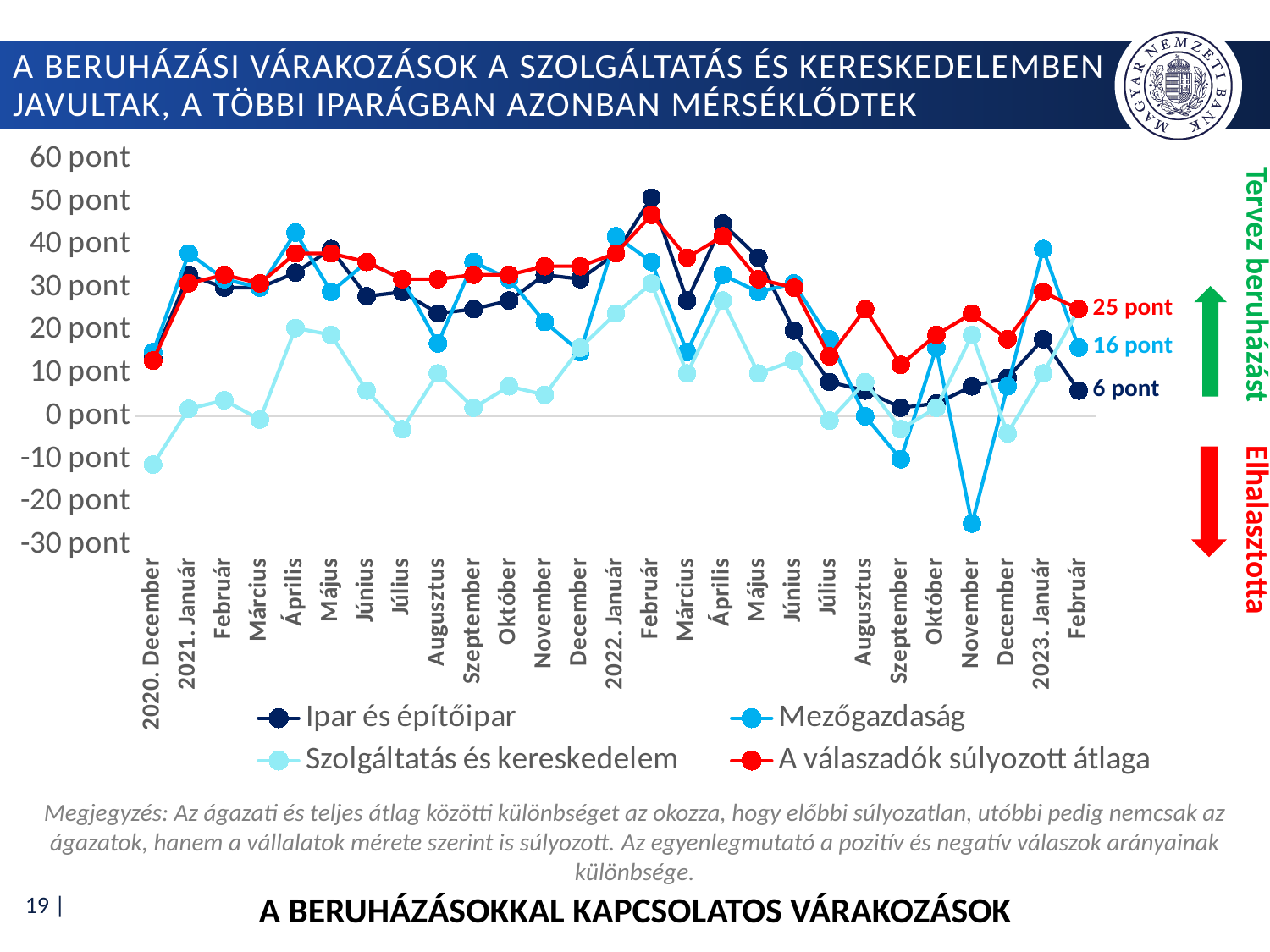
What is the value for Ipar és építőipar in 2023. Február? 6 pont Is the value for Szolgáltatás és kereskedelem in 2020. December greater or less than 0 pont? less What is the value for A válaszadók súlyozott átlaga in 2023. Február? 25 pont How many series does the legend list? 4 Is the value for Mezőgazdaság in 2022 November greater or less than -20 pont? less What colour is the line for A válaszadók súlyozott átlaga? red What kind of chart is shown on the slide? line chart Which series has the lowest value in 2023. Február? Ipar és építőipar What is the difference between A válaszadók súlyozott átlaga and Ipar és építőipar in 2023. Február? 19 pont Is the value for Ipar és építőipar in 2022. Február greater or less than 40 pont? greater In 2023. Február, which is larger: Mezőgazdaság or Ipar és építőipar? Mezőgazdaság What is the value for Mezőgazdaság in 2023. Február? 16 pont